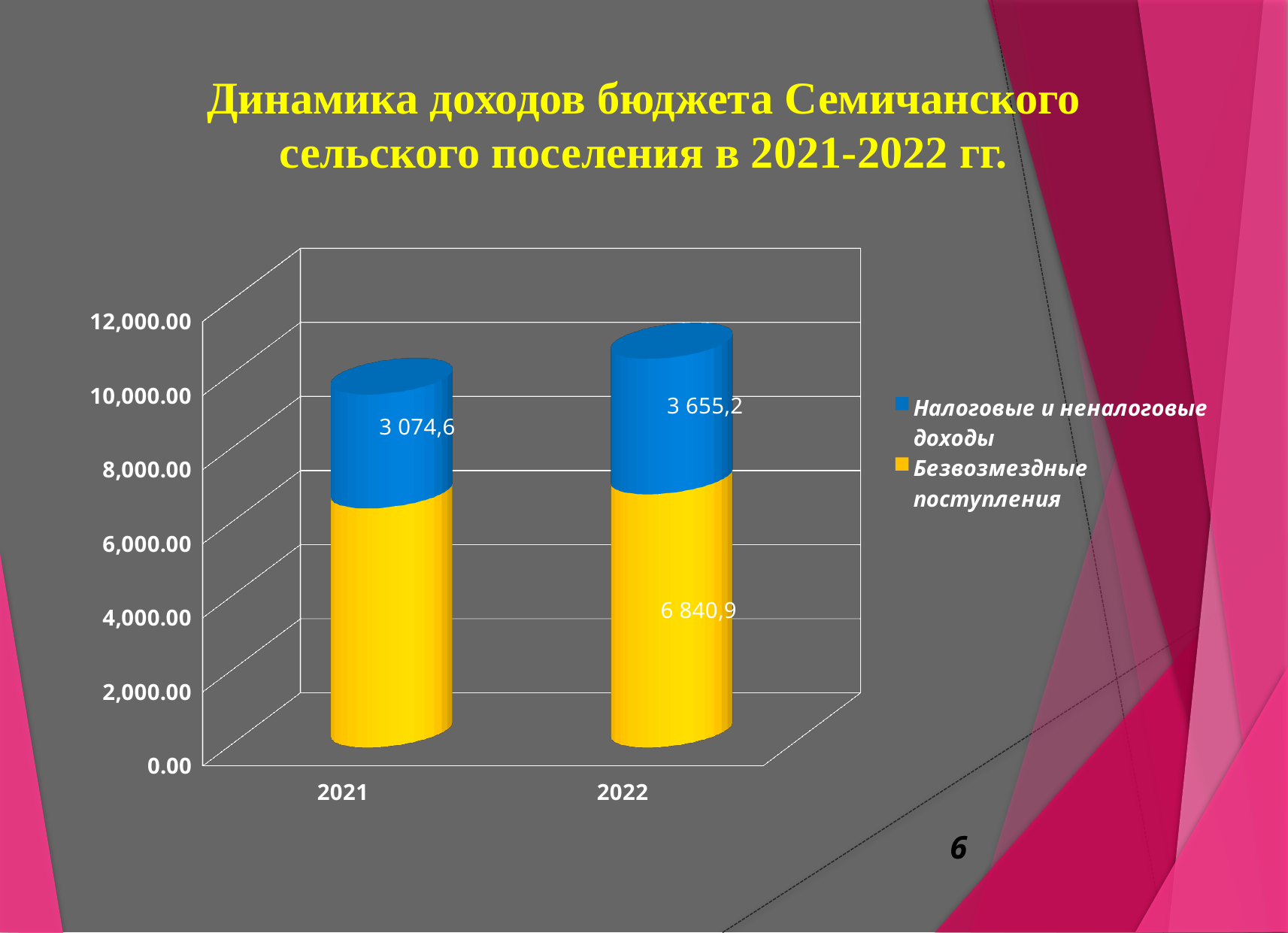
What is the value of Налоговые и неналоговые доходы for 2022? 3 655,2 Is the value of Безвозмездные поступления for 2021 greater or less than 6,000.00? greater Which year has the higher value of Налоговые и неналоговые доходы? 2022 By how much did Налоговые и неналоговые доходы increase from 2021 to 2022? 580,6 What is the value of Налоговые и неналоговые доходы for 2021? 3 074,6 In 2022, which is larger: Налоговые и неналоговые доходы or Безвозмездные поступления? Безвозмездные поступления How many series does the legend list? 2 How many years are shown on the x axis? 2 Which colour represents Безвозмездные поступления in the chart? Yellow What is the value of Безвозмездные поступления for 2022? 6 840,9 What is the total height of the stacked bar for 2022? 10 496,1 What kind of chart is shown on the slide? Stacked bar chart